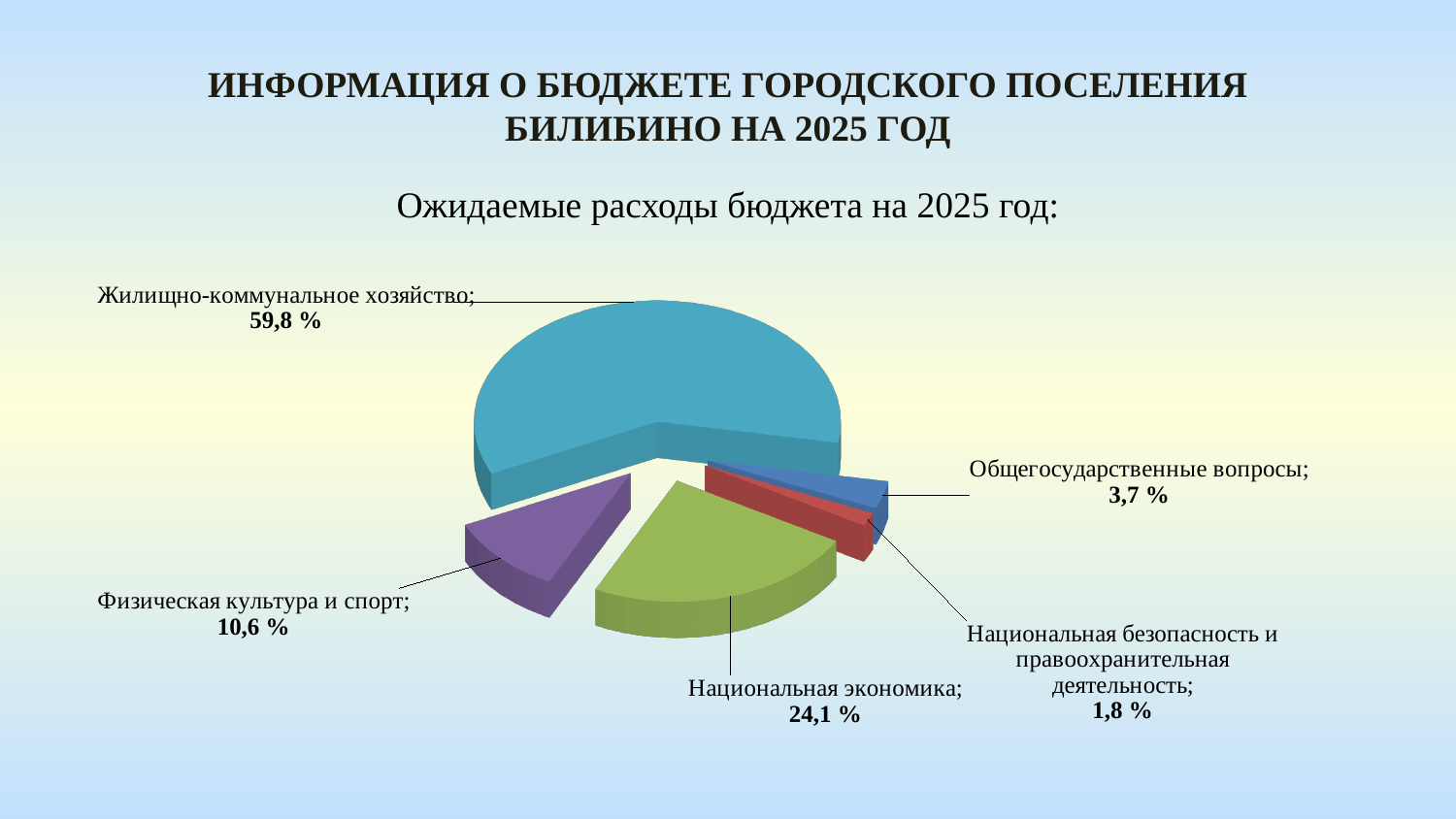
What percentage is shown for Национальная экономика? 24,1 % How many categories are shown in the pie chart? 5 What percentage is shown for Национальная безопасность и правоохранительная деятельность? 1,8 % What type of chart is shown on the slide? Pie chart What share of expected 2025 budget expenditures goes to Жилищно-коммунальное хозяйство? 59,8 % What share is labelled for Общегосударственные вопросы? 3,7 % Which is larger: the share for Физическая культура и спорт or for Общегосударственные вопросы? Физическая культура и спорт What is the subtitle above the chart? Ожидаемые расходы бюджета на 2025 год: What is the value for Физическая культура и спорт? 10,6 % Which category has the smallest share of the pie? Национальная безопасность и правоохранительная деятельность What is the difference in percentage points between Жилищно-коммунальное хозяйство and Национальная экономика? 35,7 Which category has the largest share of the pie? Жилищно-коммунальное хозяйство